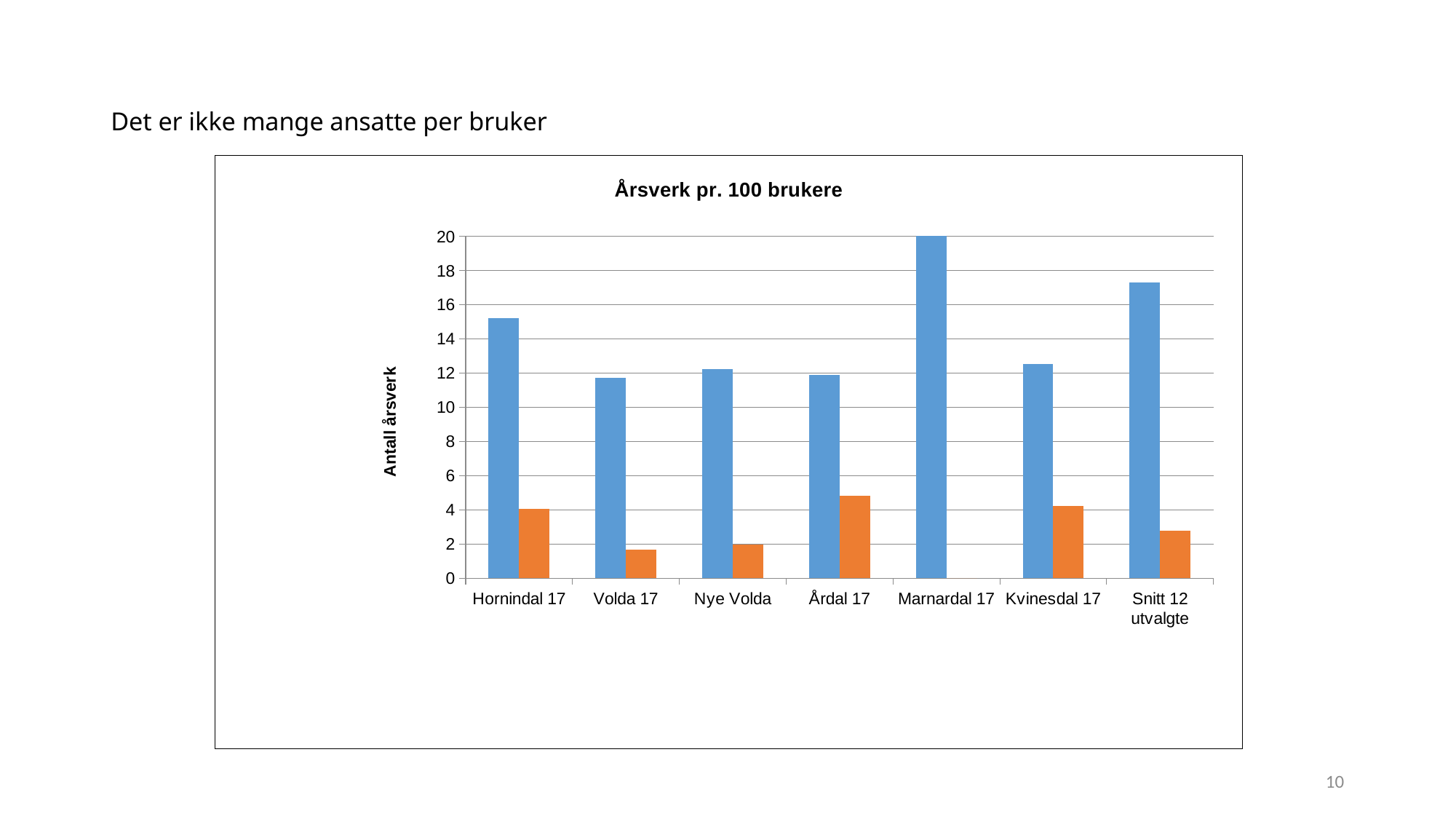
What type of chart is shown on the slide? bar chart Is the blue bar for Volda 17 greater or less than 12? less Is the orange bar for Volda 17 greater or less than 2? less Is the blue bar for Snitt 12 utvalgte greater or less than 16? greater Which category has the tallest orange bar? Årdal 17 Which has the taller blue bar, Hornindal 17 or Kvinesdal 17? Hornindal 17 How many categories are shown on the x axis of the chart? 7 Which category has the tallest blue bar? Marnardal 17 What is the label on the vertical axis of the chart? Antall årsverk What is the title of the chart? Årsverk pr. 100 brukere